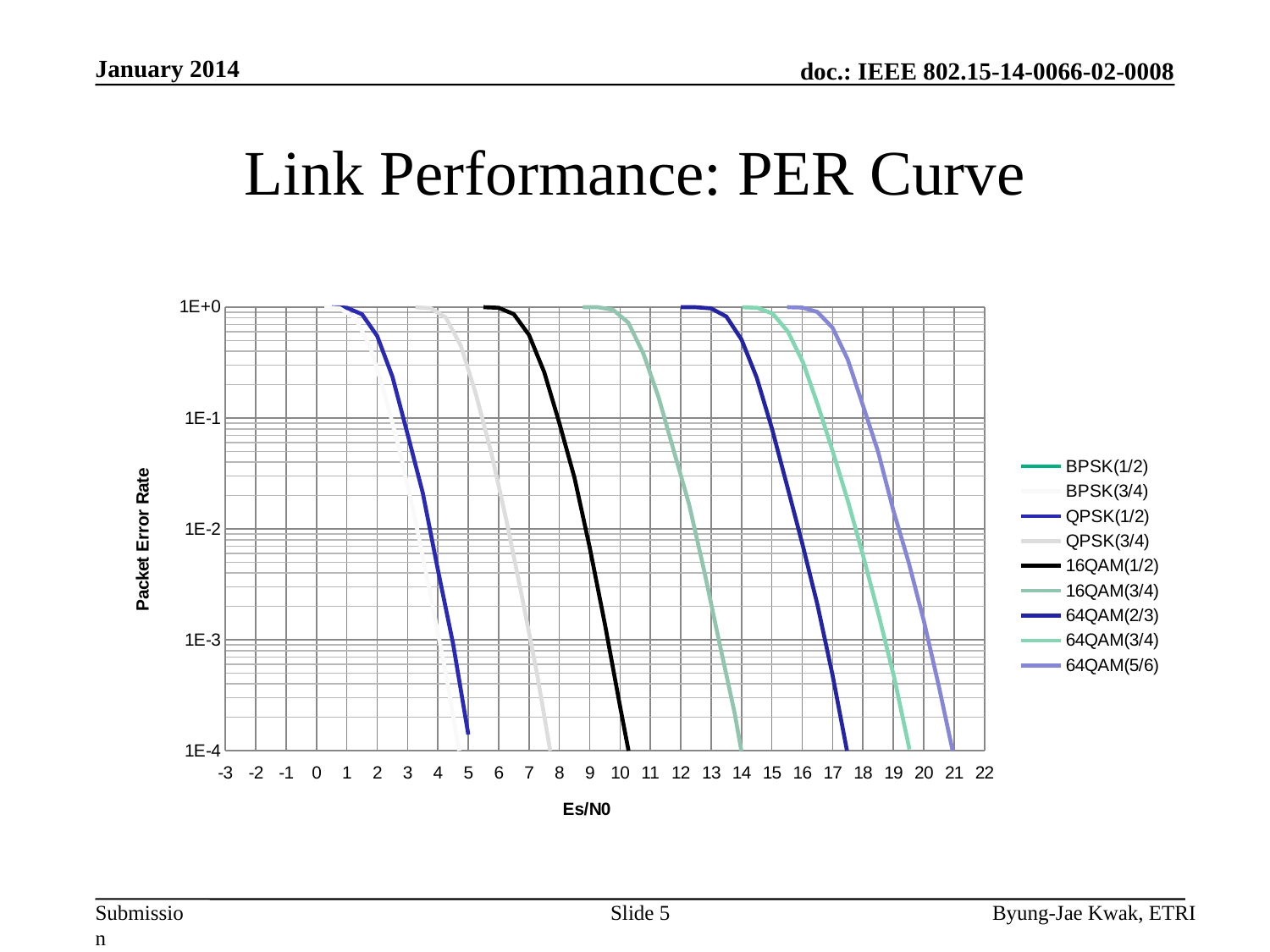
Which series reaches a Packet Error Rate of 1E-4 at a higher Es/N0, QPSK(1/2) or 64QAM(5/6)? 64QAM(5/6) Which series reaches a Packet Error Rate of 1E-4 at a lower Es/N0, 64QAM(2/3) or 64QAM(3/4)? 64QAM(2/3) What are the labels of the x axis and the y axis? Es/N0 and Packet Error Rate Is the Es/N0 at which QPSK(1/2) reaches a Packet Error Rate of 1E-4 greater or less than 7? less How many series does the legend list? 9 As Es/N0 increases along the x axis, does the Packet Error Rate for each series rise or fall? fall Is the Es/N0 at which 64QAM(2/3) reaches a Packet Error Rate of 1E-4 greater or less than 16? greater Is the Es/N0 at which 64QAM(5/6) reaches a Packet Error Rate of 1E-4 greater or less than 20? greater What is the title of the chart? Link Performance: PER Curve What kind of chart is shown on the slide? line chart Which series requires the highest Es/N0 to reach a Packet Error Rate of 1E-4? 64QAM(5/6)